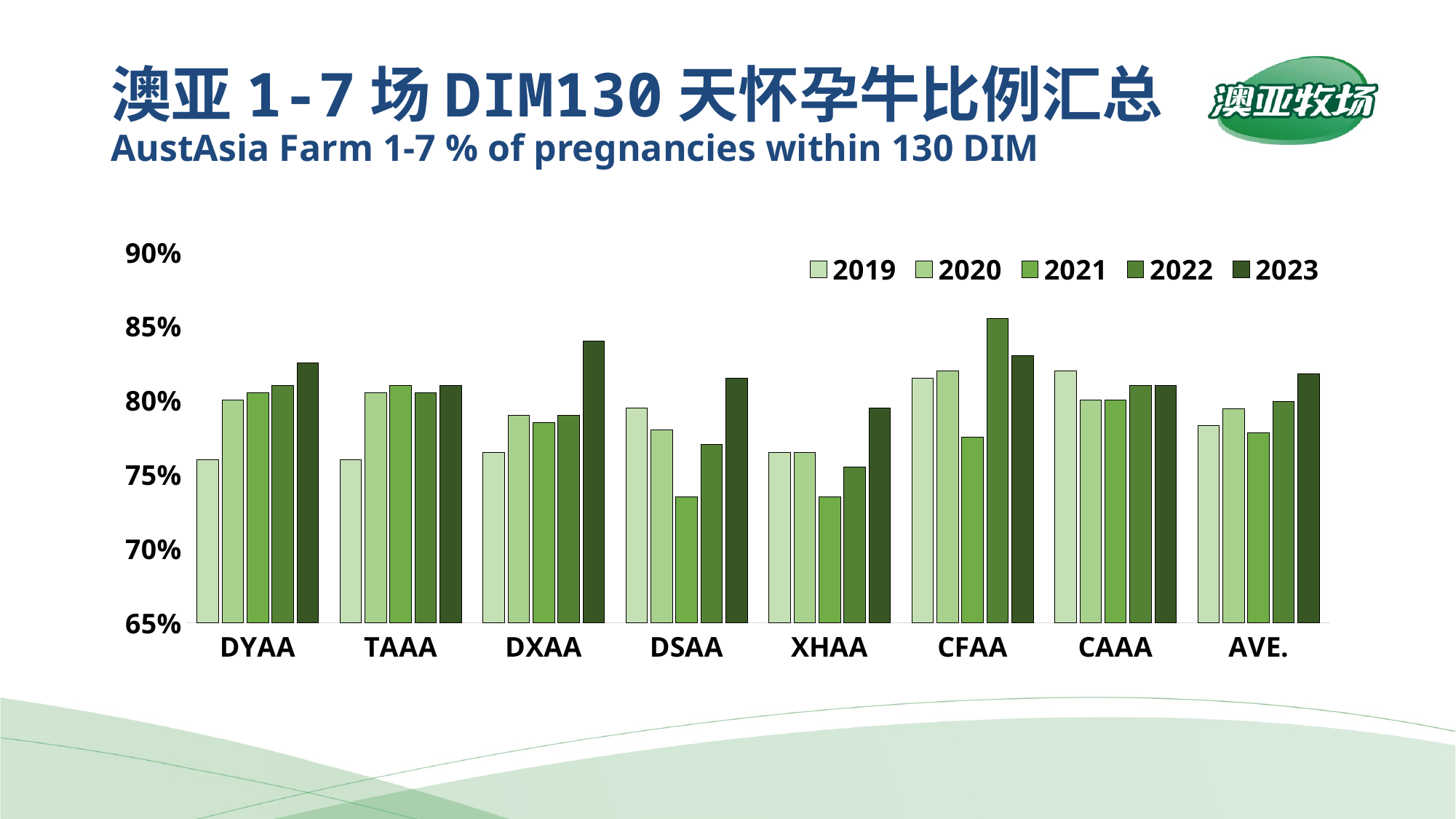
Do the values for DYAA rise or fall from 2019 to 2023? rise Which is larger for CFAA, the 2021 value or the 2022 value? 2022 Is the value for CAAA in 2019 greater or less than 80%? greater How many farm categories are shown on the x axis of the chart? 8 Is the value for CFAA in 2022 greater or less than 85%? greater Which year has the lowest value for DYAA? 2019 Which is larger, the 2023 value for DXAA or the 2023 value for DSAA? DXAA Which farm and year has the highest bar in the chart? CFAA, 2022 Is the value for DSAA in 2021 greater or less than 75%? less What kind of chart is shown on the slide? bar chart How many series does the chart legend list? 5